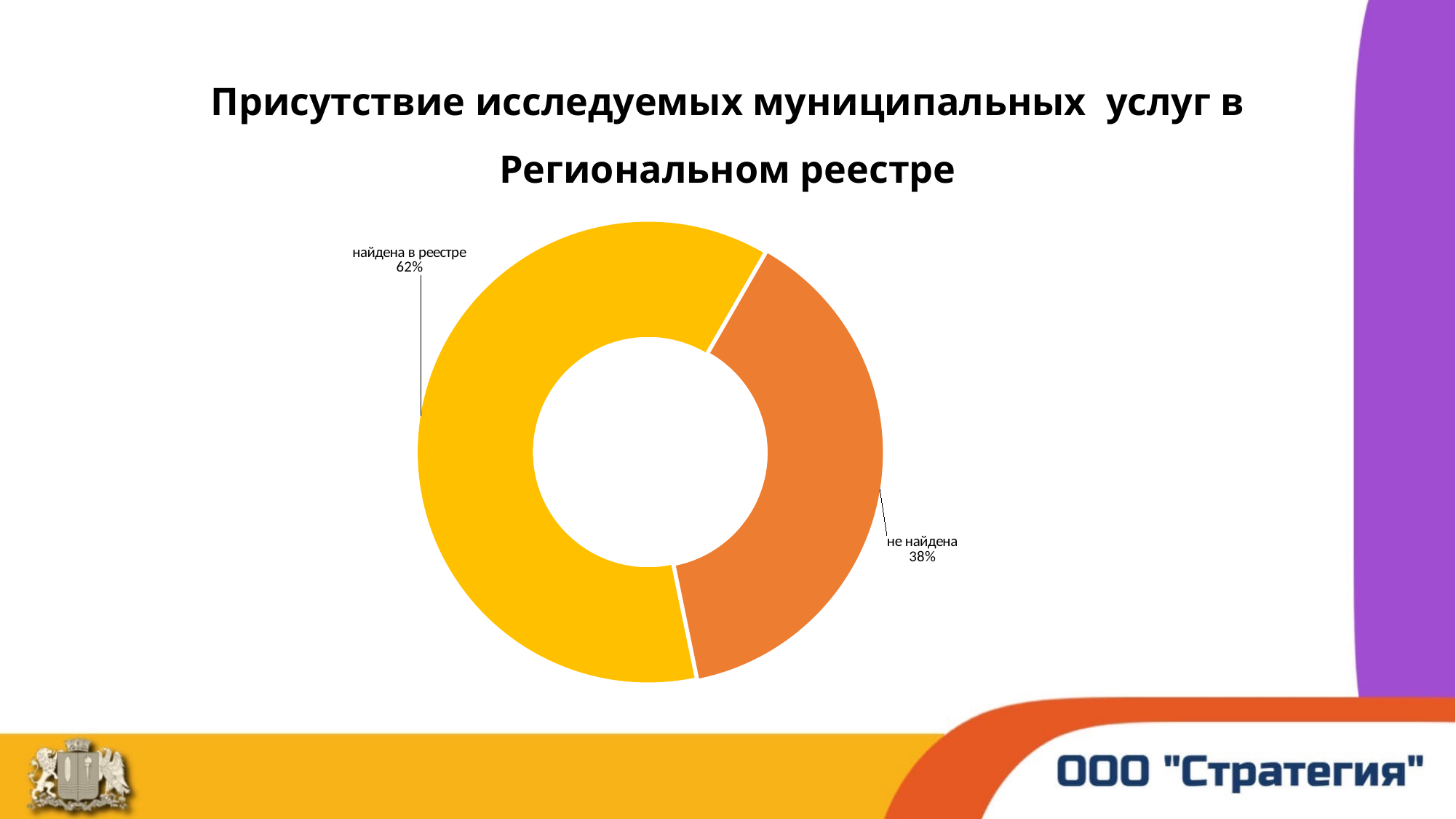
Which slice is the largest? найдена в реестре Which slice is the smallest? не найдена What share of the chart is labelled "найдена в реестре"? 62% How many slices does the chart have? 2 What colour is the "не найдена" slice? Orange Which is larger: "найдена в реестре" or "не найдена"? найдена в реестре What kind of chart is shown on the slide? Doughnut (pie) chart What is the difference in percentage points between "найдена в реестре" and "не найдена"? 24 What is the title of the slide above the chart? Присутствие исследуемых муниципальных услуг в Региональном реестре What share of the chart is labelled "не найдена"? 38%